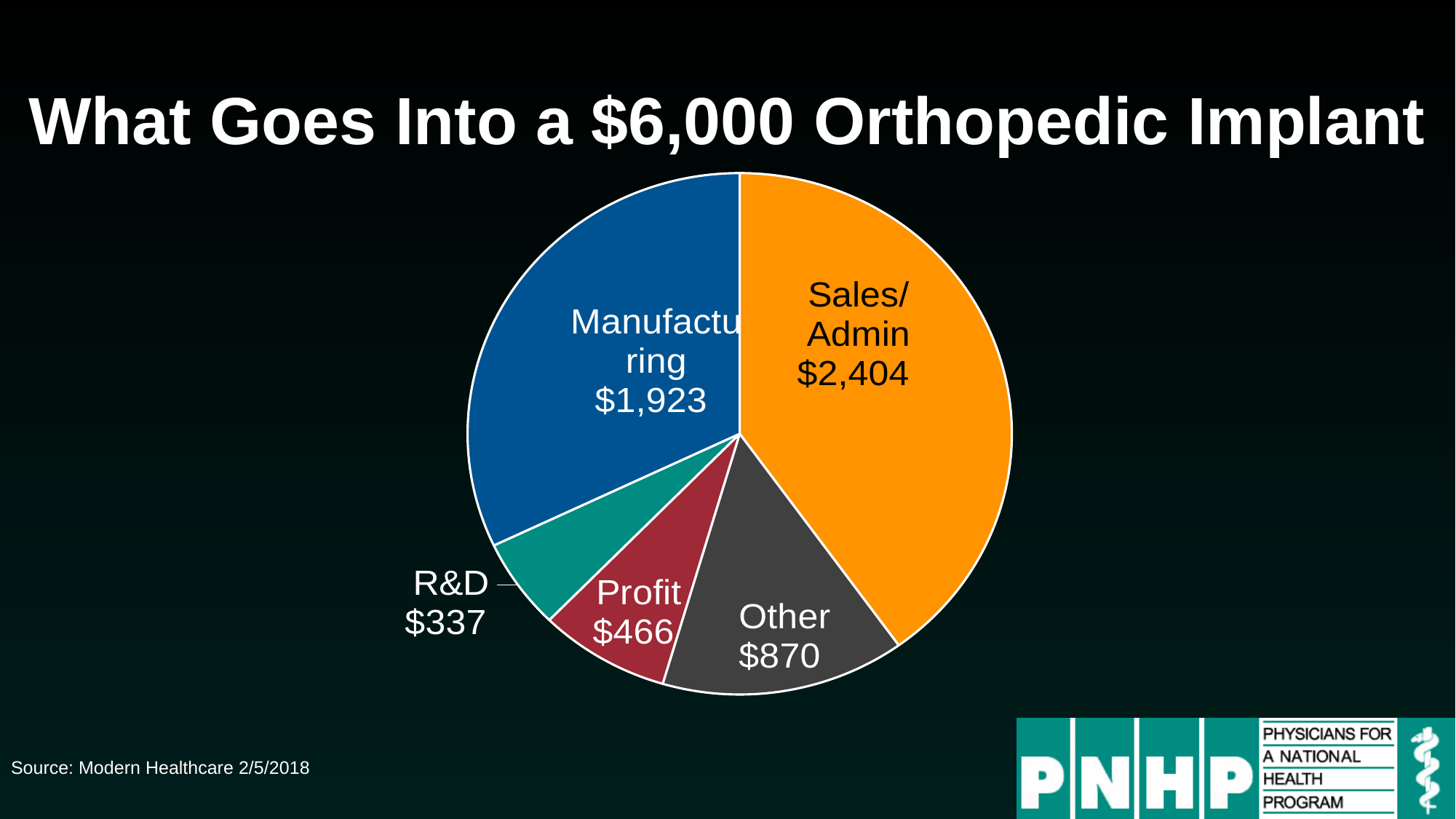
What is the value for Manufacturing? $1,923 Which category has the smallest slice of the pie? R&D What is the value for R&D? $337 Which is larger, the value for Other or the value for Profit? Other What is the value for Profit? $466 Which category has the largest slice of the pie? Sales/Admin What is the title of the chart? What Goes Into a $6,000 Orthopedic Implant How many slices does the pie chart have? 5 What is the difference between the Sales/Admin value and the Manufacturing value? $481 What kind of chart is shown on the slide? Pie chart What is the value for Sales/Admin? $2,404